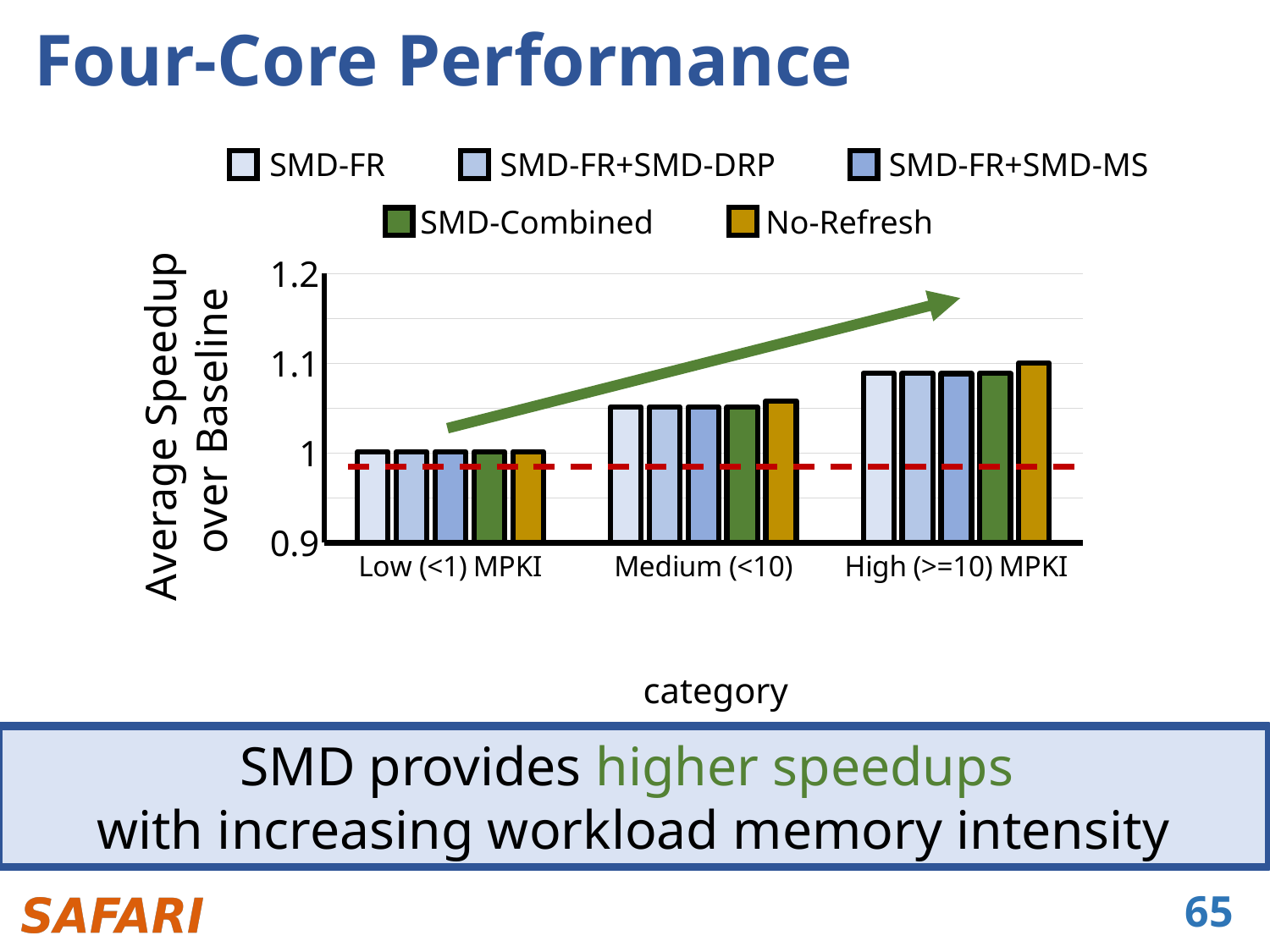
Is the SMD-FR value for High (>=10) MPKI greater or less than 1? greater Which category has the lowest value for the SMD-Combined series? Low (<1) MPKI Which legend entry is shown in green? SMD-Combined How many series does the legend list? 5 What is the label on the y axis of the chart? Average Speedup over Baseline Is the SMD-Combined value for Low (<1) MPKI greater or less than 1.1? less Which is larger: the SMD-FR+SMD-MS value for High (>=10) MPKI or for Medium (<10)? High (>=10) MPKI What kind of chart is shown on the slide? bar chart Is the No-Refresh value for Medium (<10) greater or less than 1.1? less Do the values for each series rise or fall moving from Low (<1) MPKI to High (>=10) MPKI? rise How many categories are shown on the x axis? 3 Which category has the highest value for the No-Refresh series? High (>=10) MPKI